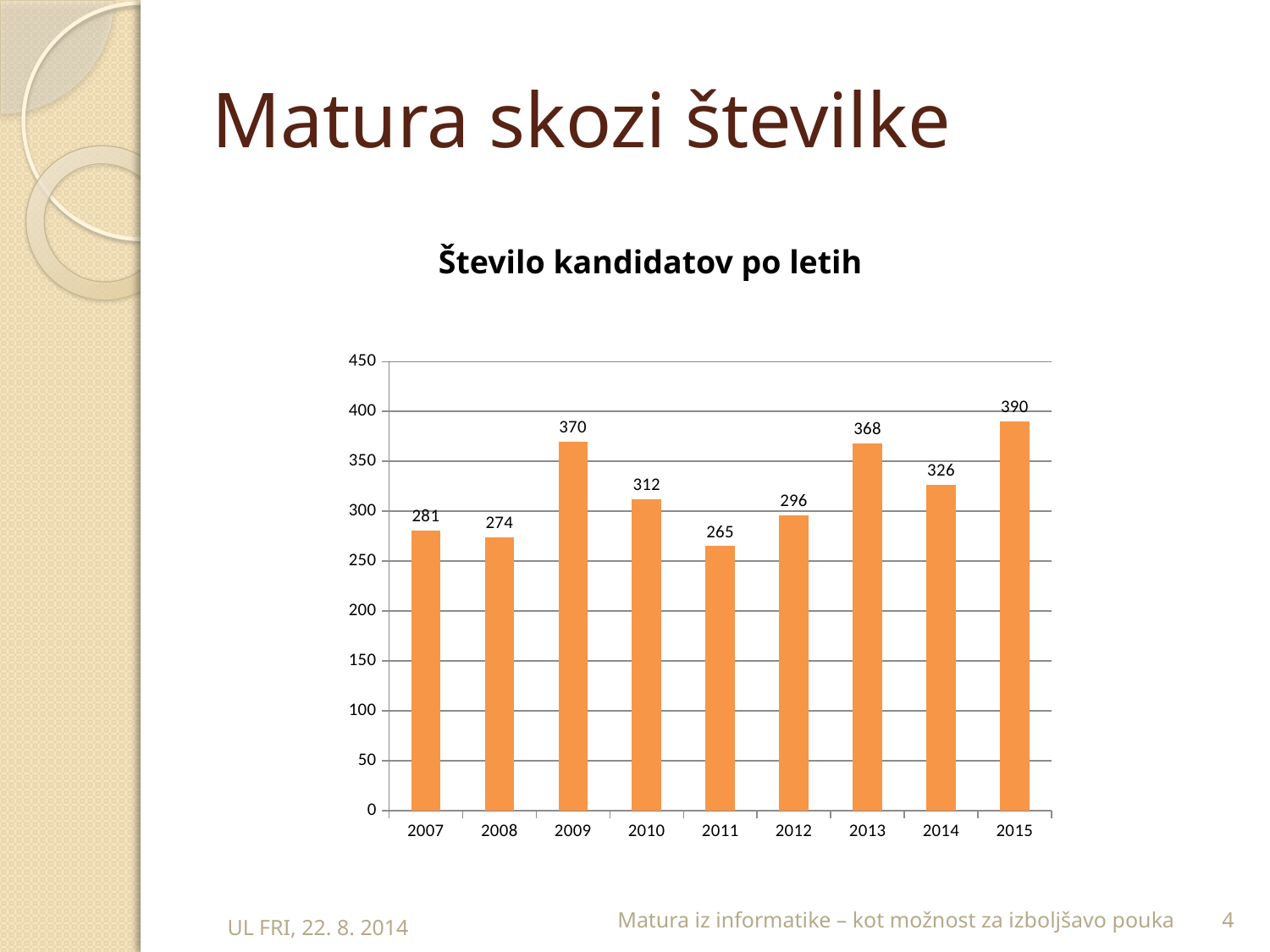
Which year has the highest value? 2015 How many years are shown on the x axis? 9 Is the value for 2008 greater or less than 300? less What kind of chart is this? bar chart Which is larger, the value for 2010 or the value for 2012? 2010 What is the difference between the values for 2015 and 2007? 109 What is the title of the chart? Število kandidatov po letih What is the value for 2009? 370 Which year has the lowest value? 2011 What is the difference between the values for 2013 and 2012? 72 What is the value for 2014? 326 What is the value for 2011? 265